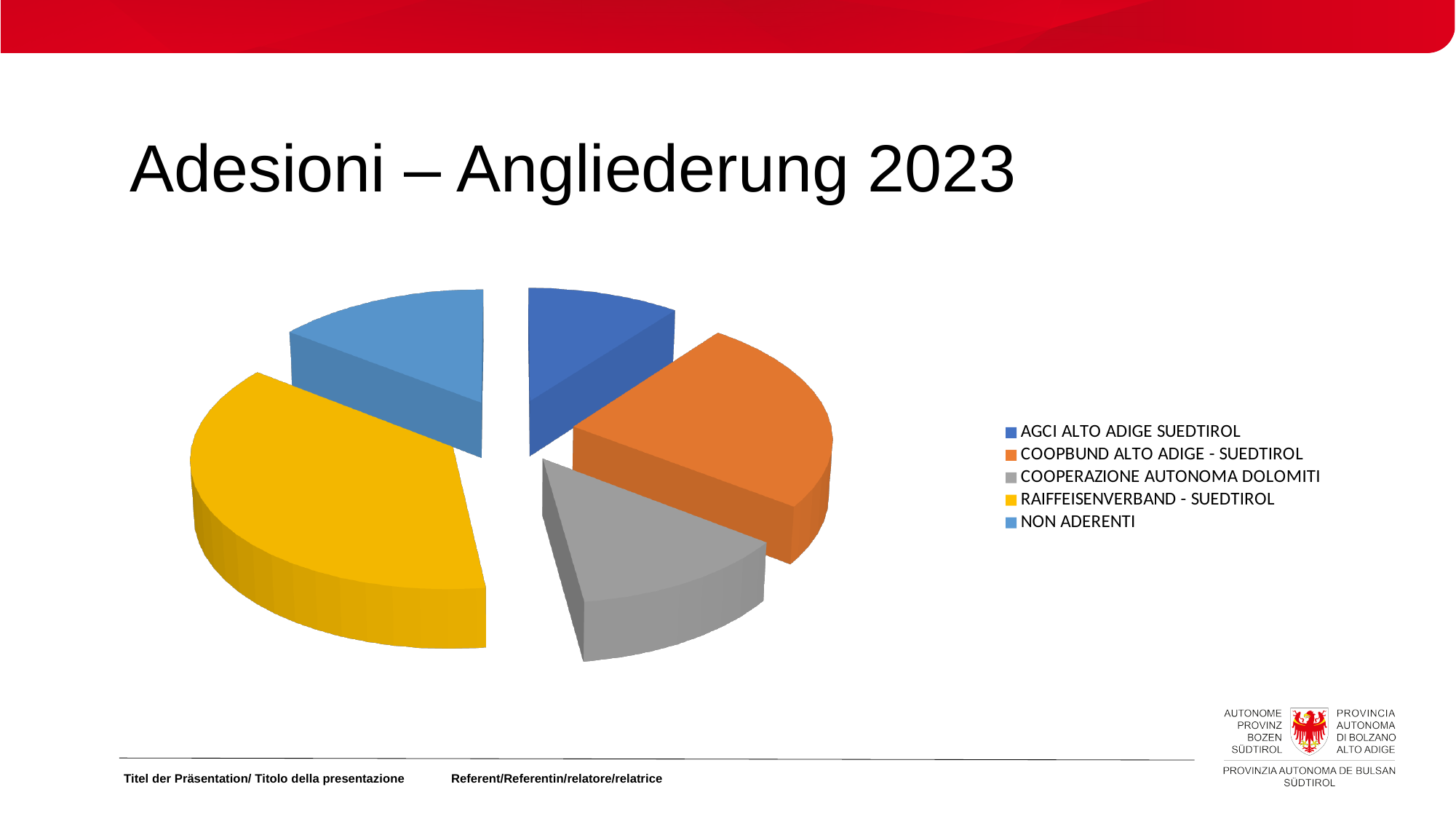
Which slice is larger, RAIFFEISENVERBAND - SUEDTIROL or AGCI ALTO ADIGE SUEDTIROL? RAIFFEISENVERBAND - SUEDTIROL What colour is the slice for RAIFFEISENVERBAND - SUEDTIROL? yellow How many slices does the pie chart have? 5 Which category has the largest slice of the pie? RAIFFEISENVERBAND - SUEDTIROL Which slice is larger, RAIFFEISENVERBAND - SUEDTIROL or COOPBUND ALTO ADIGE - SUEDTIROL? RAIFFEISENVERBAND - SUEDTIROL What kind of chart is shown on the slide? pie chart Which slice is larger, COOPBUND ALTO ADIGE - SUEDTIROL or AGCI ALTO ADIGE SUEDTIROL? COOPBUND ALTO ADIGE - SUEDTIROL What is the title of the slide containing the pie chart? Adesioni – Angliederung 2023 How many entries does the chart legend list? 5